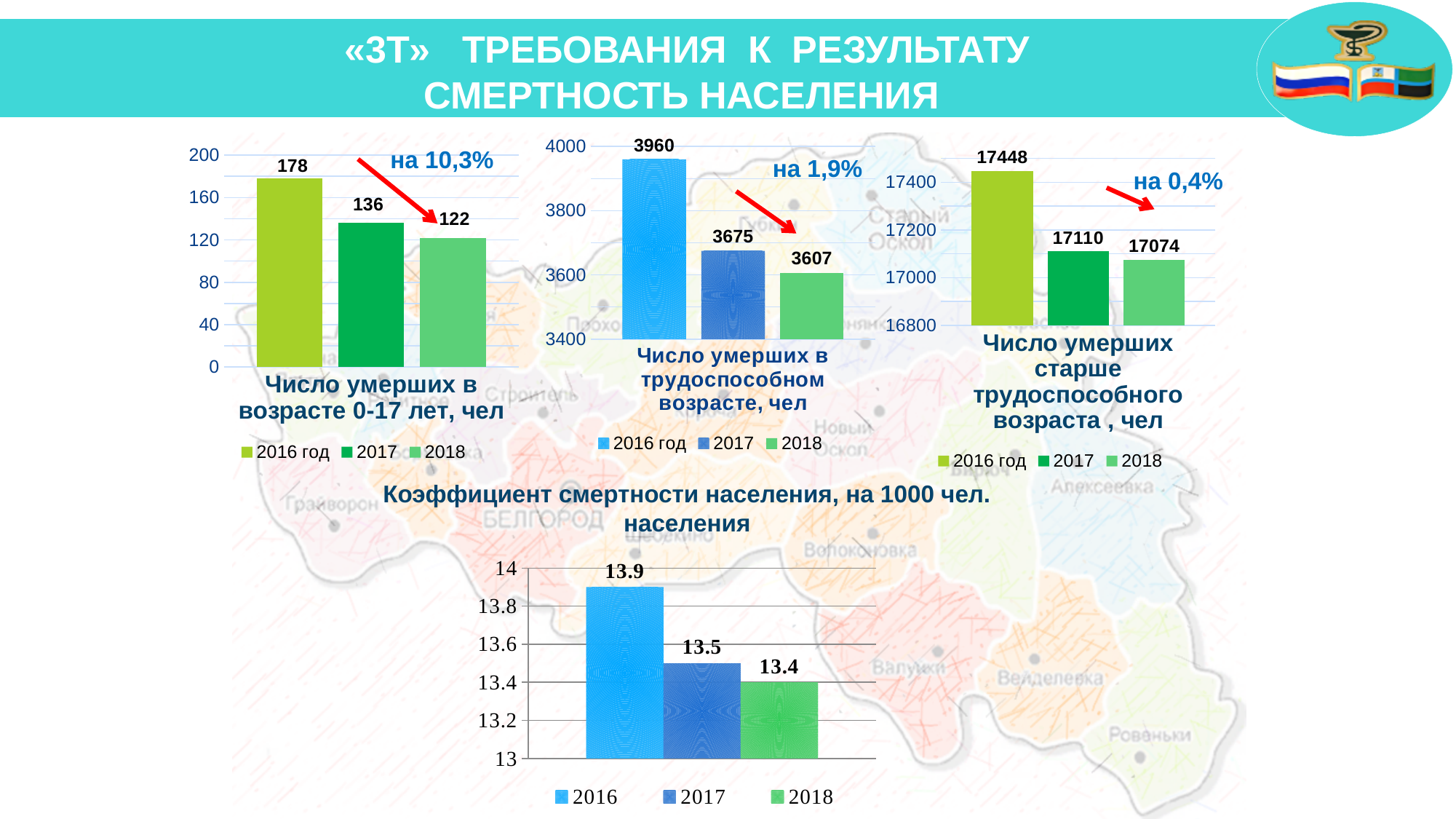
In the chart titled «Число умерших старше трудоспособного возраста, чел», what is the difference between the 2017 and 2018 values? 36 In the chart titled «Число умерших старше трудоспособного возраста, чел», what is the value for 2016? 17448 In the chart titled «Коэффициент смертности населения, на 1000 чел. населения», what is the value for 2018? 13.4 In the chart titled «Число умерших в трудоспособном возрасте, чел», what is the value for 2017? 3675 In the chart titled «Коэффициент смертности населения, на 1000 чел. населения», which year has the highest value? 2016 In the chart titled «Число умерших в возрасте 0-17 лет, чел», what is the value for 2016? 178 In the chart titled «Число умерших в возрасте 0-17 лет, чел», what is the difference between the 2016 and 2018 values? 56 What kind of chart is the chart titled «Коэффициент смертности населения, на 1000 чел. населения»? bar chart How many series does the legend of the chart titled «Число умерших в трудоспособном возрасте, чел» list? 3 In the chart titled «Число умерших в возрасте 0-17 лет, чел», which is larger, the value for 2017 or the value for 2018? 2017 In the chart titled «Коэффициент смертности населения, на 1000 чел. населения», do the values rise or fall from 2016 to 2018? fall In the chart titled «Число умерших в трудоспособном возрасте, чел», which year has the lowest value? 2018